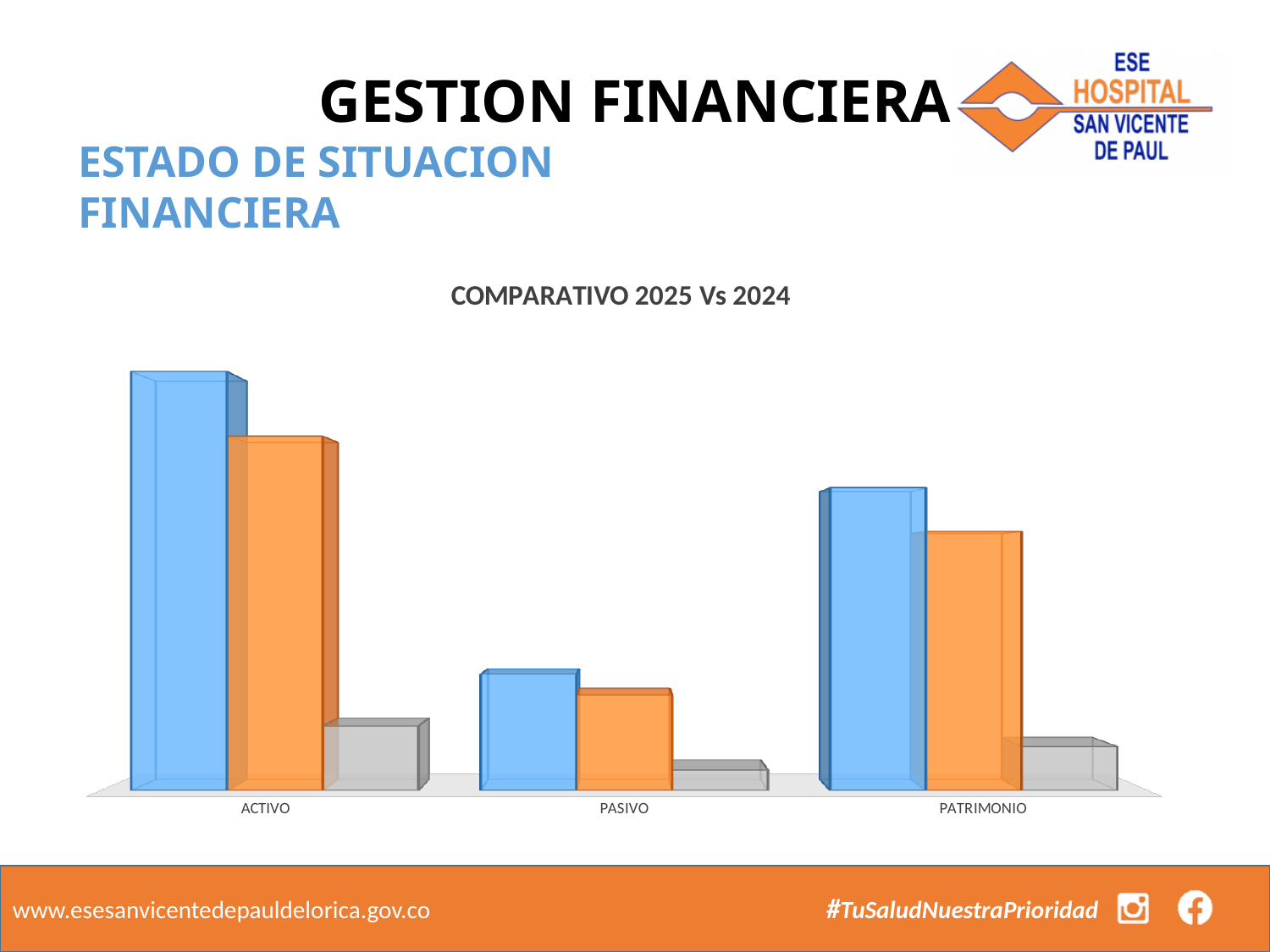
Which is taller, the blue bar for PATRIMONIO or the blue bar for PASIVO? PATRIMONIO Which category has the tallest blue bar? ACTIVO What kind of chart is shown on the slide? Bar chart For ACTIVO, which bar is taller, the blue bar or the orange bar? Blue bar How many bars are shown for each category in the chart? 3 Which is taller, the gray bar for ACTIVO or the gray bar for PATRIMONIO? ACTIVO Which category has the tallest orange bar? ACTIVO Which category has the shortest blue bar? PASIVO What colours are the three bars in each category of the chart? Blue, orange and gray Which category has the shortest gray bar? PASIVO What is the title of the chart? COMPARATIVO 2025 Vs 2024 How many categories are shown on the x axis of the chart? 3